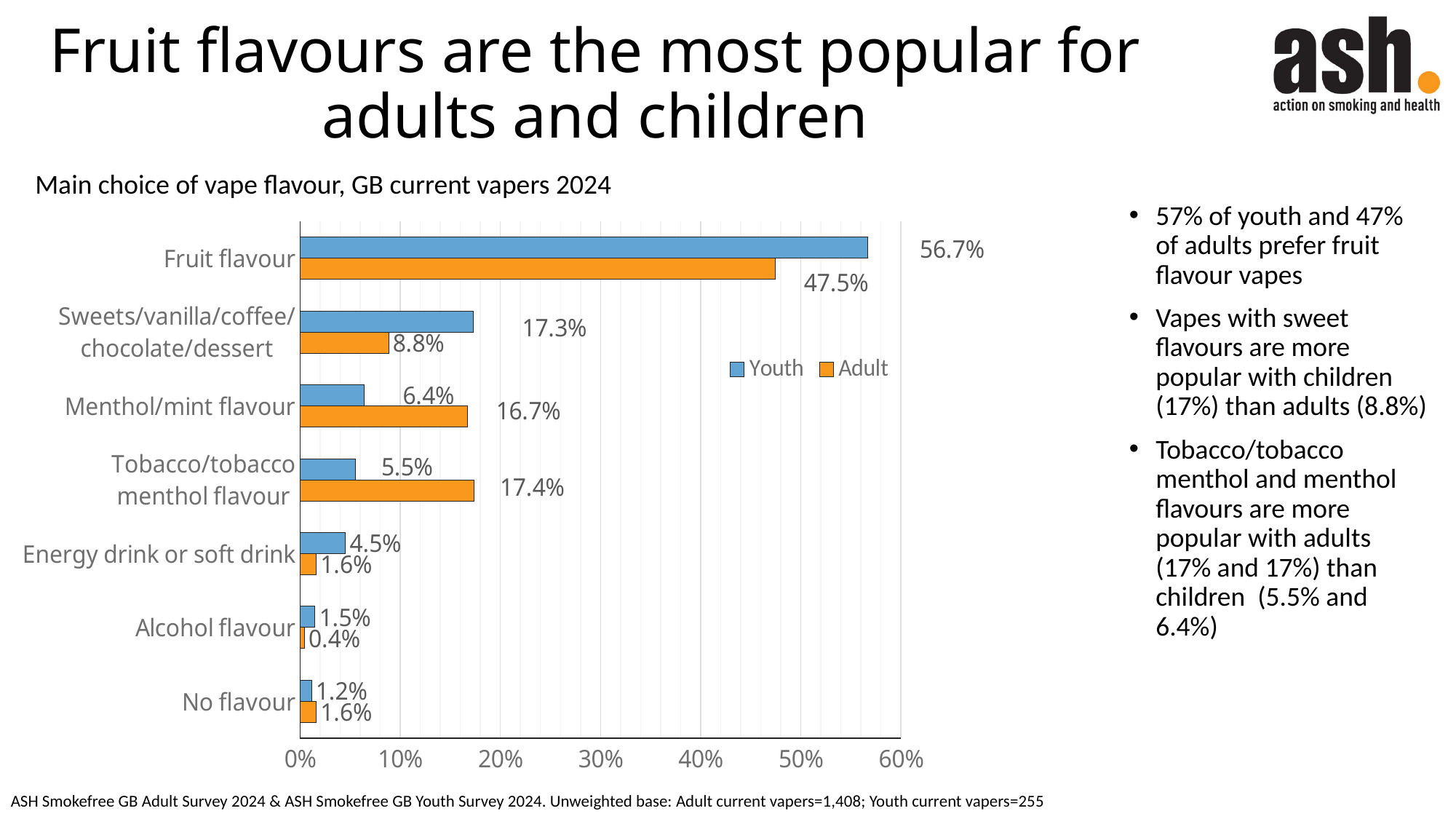
How many flavour categories are shown on the chart? 7 Which is larger for Menthol/mint flavour, the Youth value or the Adult value? Adult What is the Adult value for Sweets/vanilla/coffee/chocolate/dessert? 8.8% Which category has the highest Youth value? Fruit flavour What is the Adult value for Fruit flavour? 47.5% What is the difference between the Youth and Adult values for Fruit flavour? 9.2% How many series does the legend list? 2 Is the Youth value for Sweets/vanilla/coffee/chocolate/dessert greater or less than 10%? greater What kind of chart is shown on the slide? Bar chart What is the Adult value for Tobacco/tobacco menthol flavour? 17.4% What is the Youth value for Fruit flavour? 56.7% Which category has the lowest Adult value? Alcohol flavour